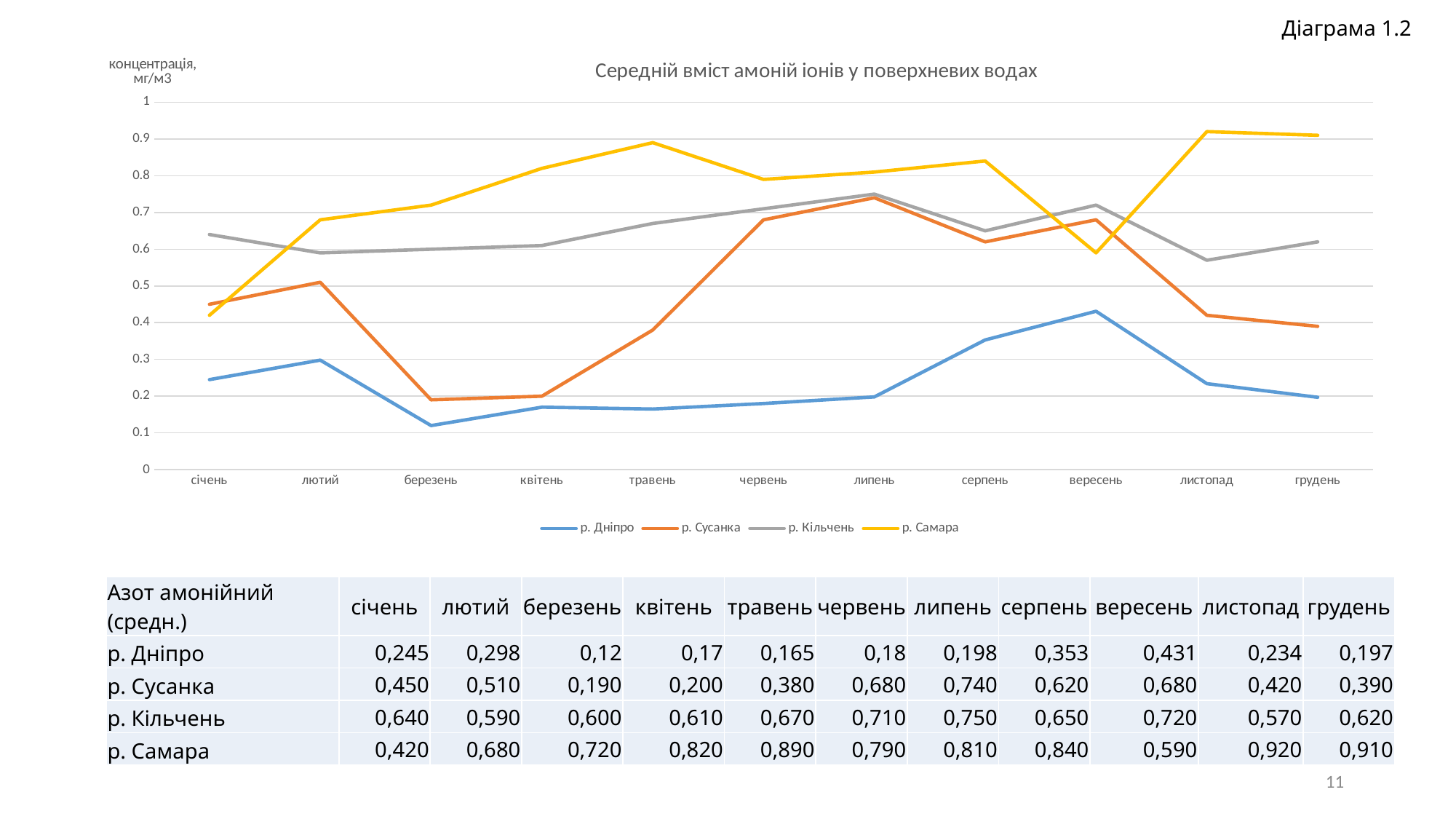
In which month does р. Самара reach its highest value? листопад What is the value for р. Самара in травень? 0,890 How many series does the legend of the chart list? 4 What type of chart is shown on the slide? line chart Does the value for р. Самара rise or fall from січень to травень? rise In which month does р. Дніпро have its lowest value? березень Is the value for р. Кільчень in січень greater or less than 0.5? greater Which series has the larger value in червень, р. Сусанка or р. Дніпро? р. Сусанка What is the value for р. Кільчень in липень? 0,750 How many months are plotted along the x axis of the chart? 11 What is the value for р. Дніпро in вересень? 0,431 What is the difference between the values for р. Самара and р. Кільчень in травень? 0,220